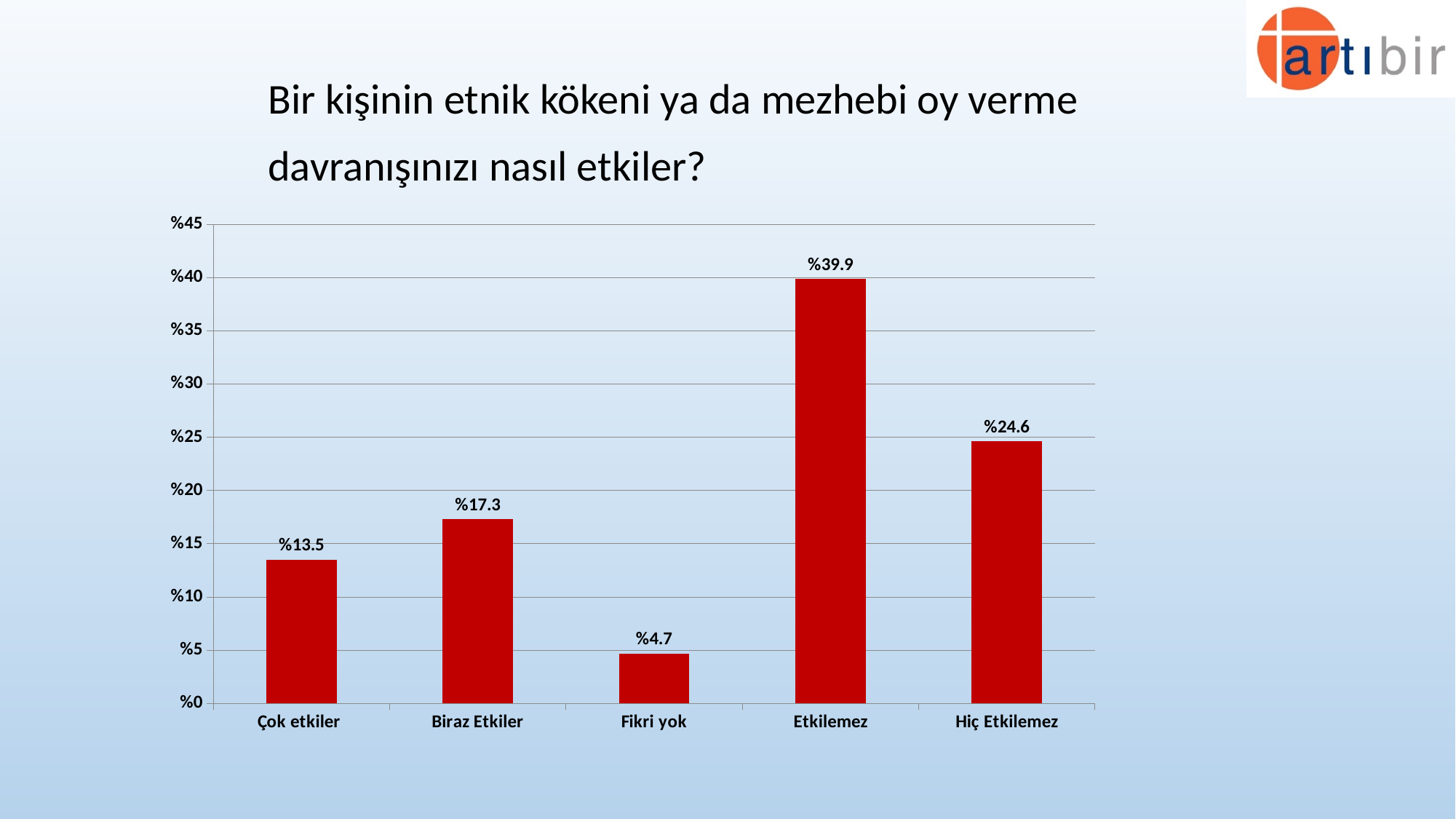
What is the value for Hiç Etkilemez? %24.6 Which category has the highest value? Etkilemez What kind of chart is shown on the slide? bar chart What is the value for Etkilemez? %39.9 Which is larger, the value for Biraz Etkiler or the value for Çok etkiler? Biraz Etkiler What is the value for Çok etkiler? %13.5 What is the value for Fikri yok? %4.7 How many categories are shown on the x axis? 5 What colour are the bars in the chart? red Is the value for Hiç Etkilemez greater or less than %20? greater Which category has the lowest value? Fikri yok What is the difference between the values for Etkilemez and Hiç Etkilemez? %15.3